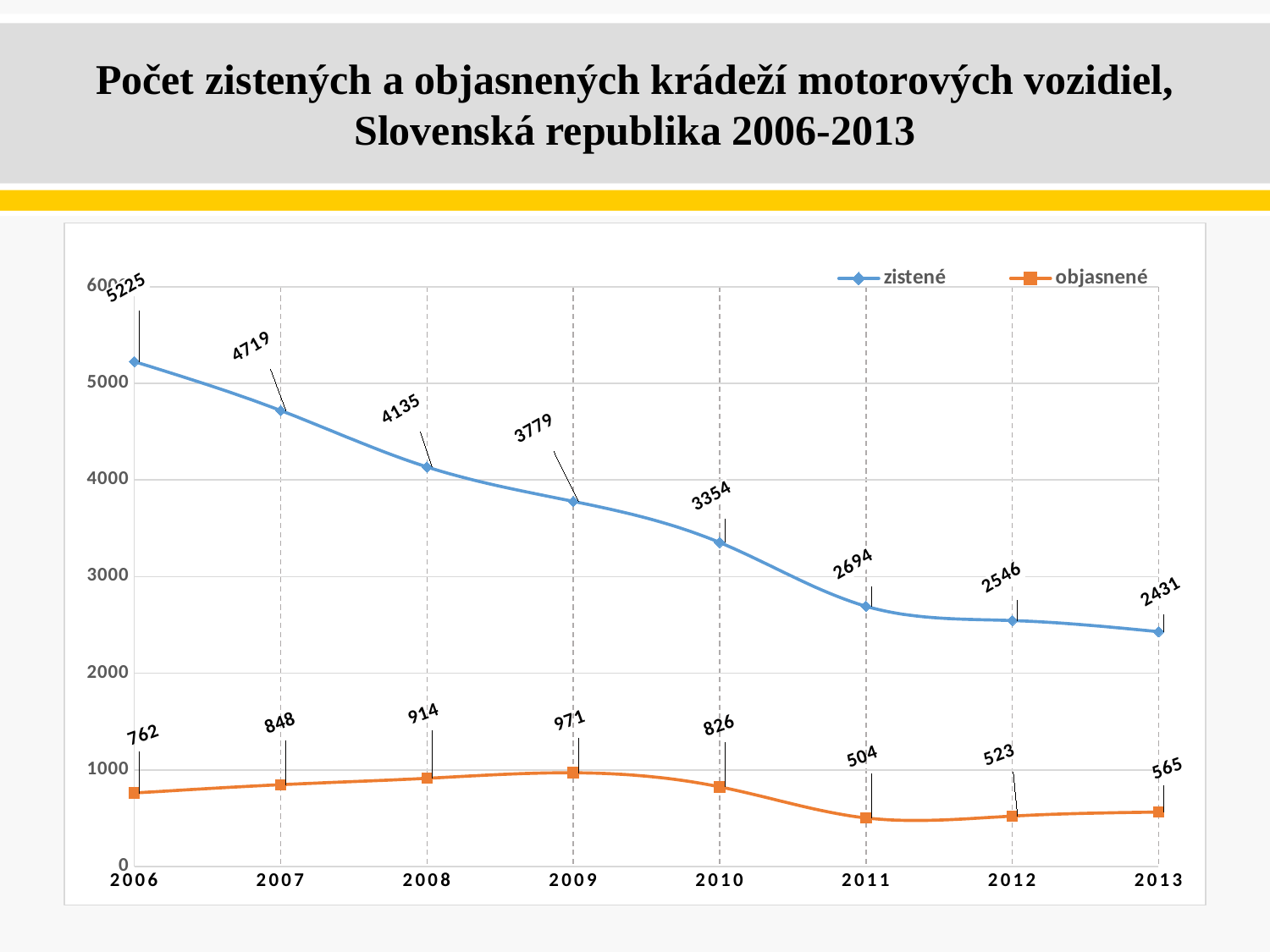
How many series does the legend list? 2 What is the difference between the zistené and objasnené values in 2011? 2190 What is the difference between the zistené values in 2006 and 2013? 2794 What is the value of the zistené series in 2013? 2431 What is the value of the zistené series in 2006? 5225 In which year is the objasnené series lowest? 2011 What is the value of the objasnené series in 2009? 971 What kind of chart is shown on the slide? line chart In which year is the zistené series lowest? 2013 In which year is the objasnené series highest? 2009 How many years are shown on the x axis? 8 Which is larger, the objasnené value in 2007 or in 2012? 2007